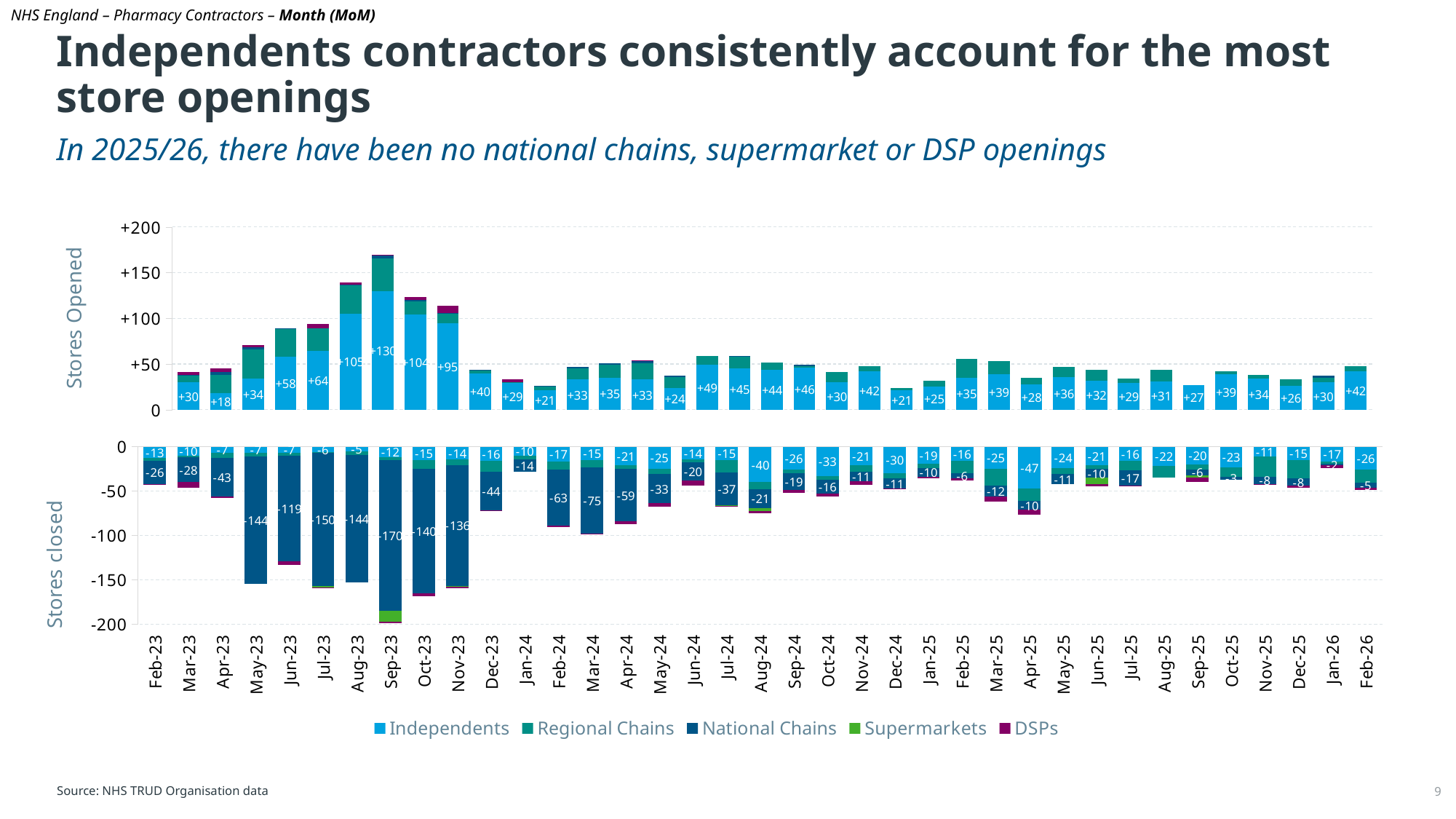
In the Stores Opened panel, which month has the lowest Independents value? Mar-23 In the Stores closed panel, what is the value for Independents in Apr-25? -47 In the Stores Opened panel, which month has the highest Independents value? Aug-23 How many series does the legend list? 5 In the Stores Opened panel, what is the value for Independents in Aug-23? +130 How many months are shown along the x axis? 37 In the Stores Opened panel, do the Independents values rise or fall from May-23 to Aug-23? rise In the Stores Opened panel, is the total height of the Aug-23 bar greater or less than 150? greater In the Stores Opened panel, what is the difference between the Independents values for Aug-23 and Sep-23? 26 What kind of chart is shown on the slide? Stacked bar chart In the Stores Opened panel, which month has the larger Independents value, Jun-24 or Jul-24? Jun-24 In the Stores closed panel, what is the value for National Chains in Sep-23? -170